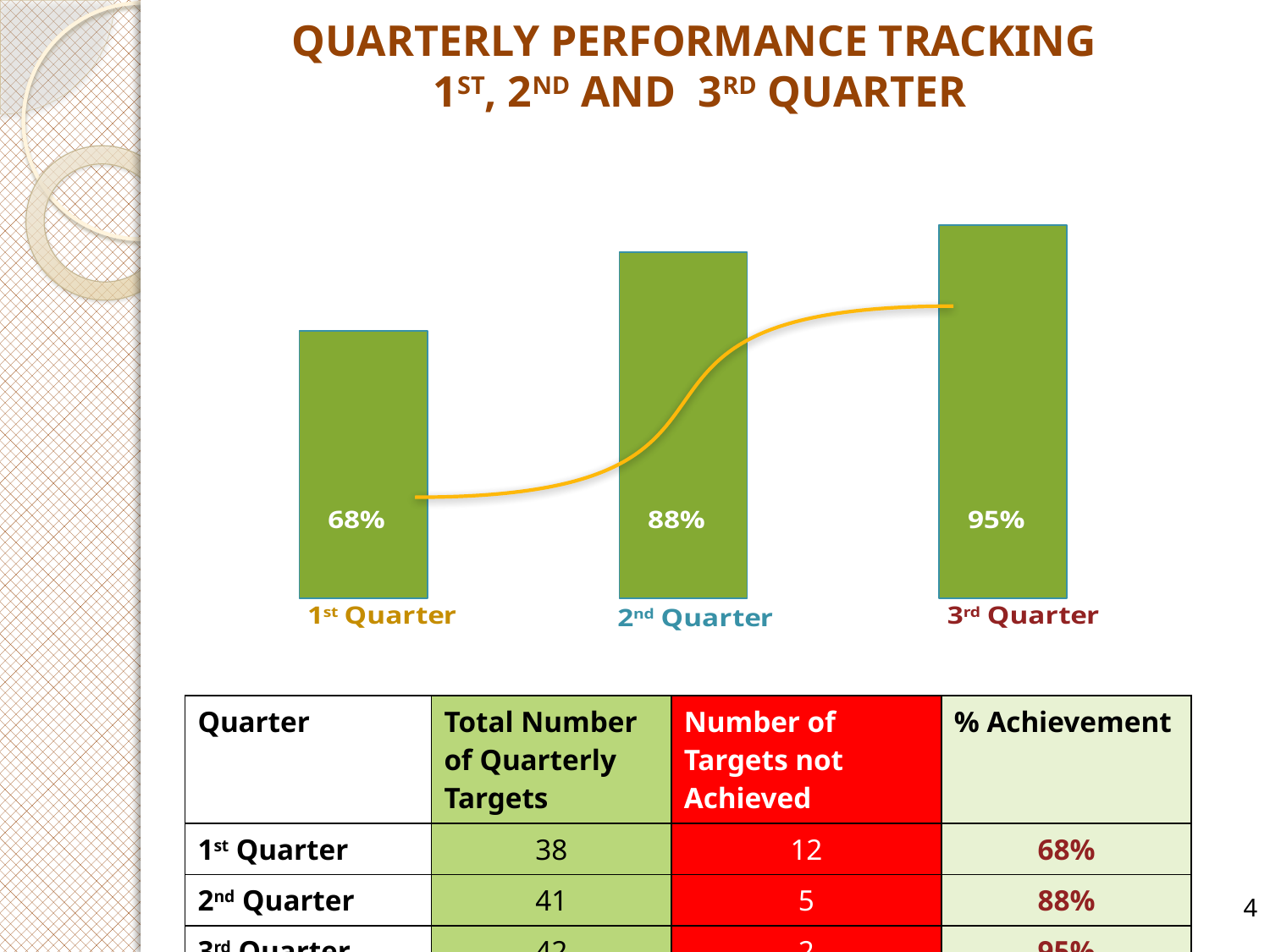
What colour are the bars in the chart? green Which quarter has the lowest value in the chart? 1st Quarter Do the values rise or fall from the 1st Quarter to the 3rd Quarter? rise Which quarter has the highest value in the chart? 3rd Quarter What kind of chart is shown on the slide? bar chart What is the value shown for the 1st Quarter bar? 68% What is the value shown for the 3rd Quarter bar? 95% What is the difference between the 3rd Quarter and 2nd Quarter values? 7% How many quarters are plotted in the chart? 3 What is the value shown for the 2nd Quarter bar? 88% Which is larger, the value for the 1st Quarter or the 2nd Quarter? 2nd Quarter What is the difference between the 2nd Quarter and 1st Quarter values? 20%